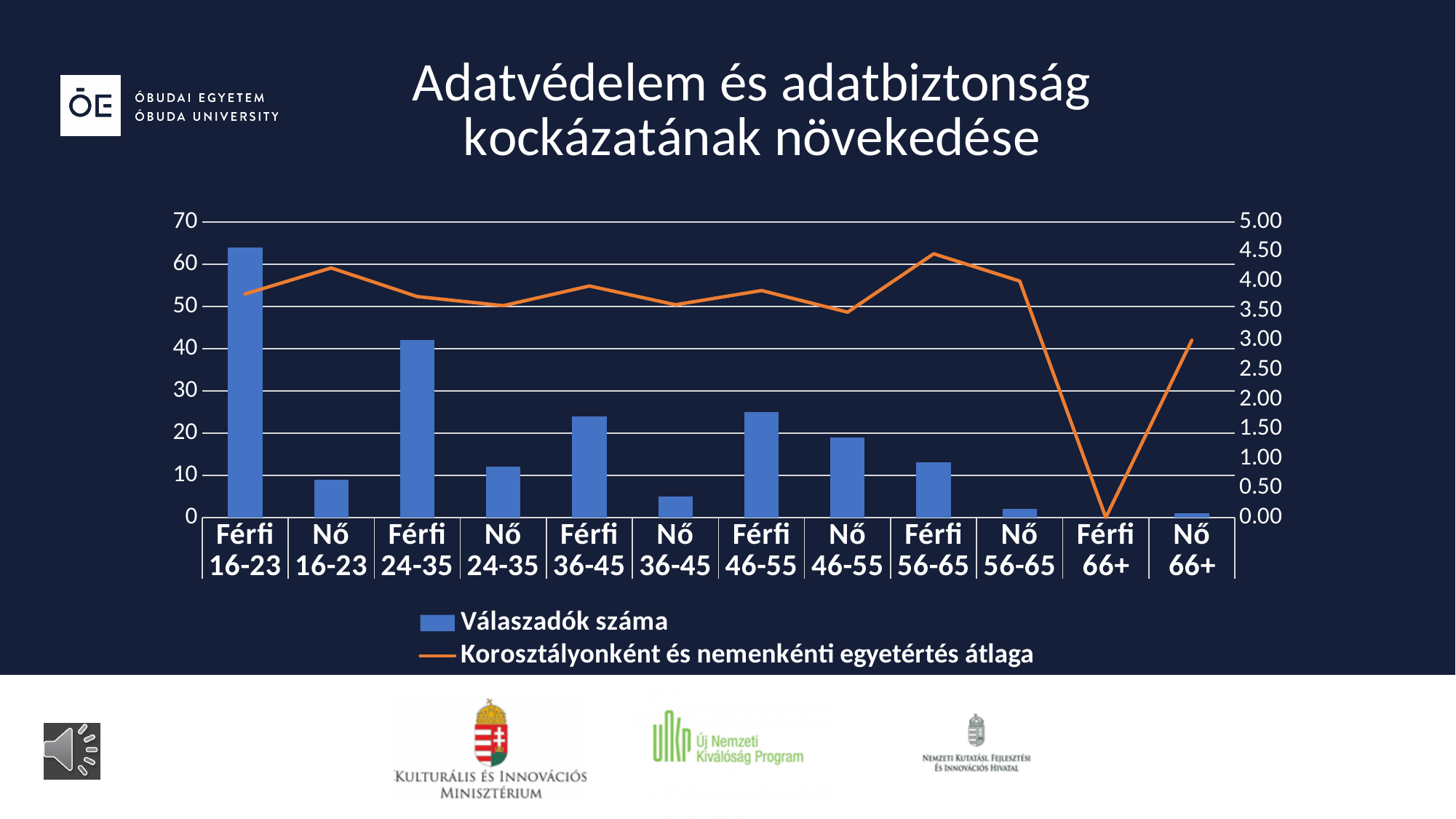
What is the value of the Korosztályonként és nemenkénti egyetértés átlaga line for Férfi 66+? 0.00 What kind of chart is shown on the slide? A combined bar and line chart At which category does the Korosztályonként és nemenkénti egyetértés átlaga line reach its highest point? Férfi 56-65 How many categories are shown on the x axis of the chart? 12 Which category has the lowest bar for Válaszadók száma? Férfi 66+ Is the Válaszadók száma value for Férfi 24-35 greater or less than 40? greater Is the Válaszadók száma value for Nő 16-23 greater or less than 10? less Which has the larger Válaszadók száma bar, Férfi 24-35 or Férfi 36-45? Férfi 24-35 What is the title of the chart on the slide? Adatvédelem és adatbiztonság kockázatának növekedése Is the Válaszadók száma value for Férfi 16-23 greater or less than 60? greater How many series does the chart legend list? 2 Which category has the highest bar for Válaszadók száma? Férfi 16-23